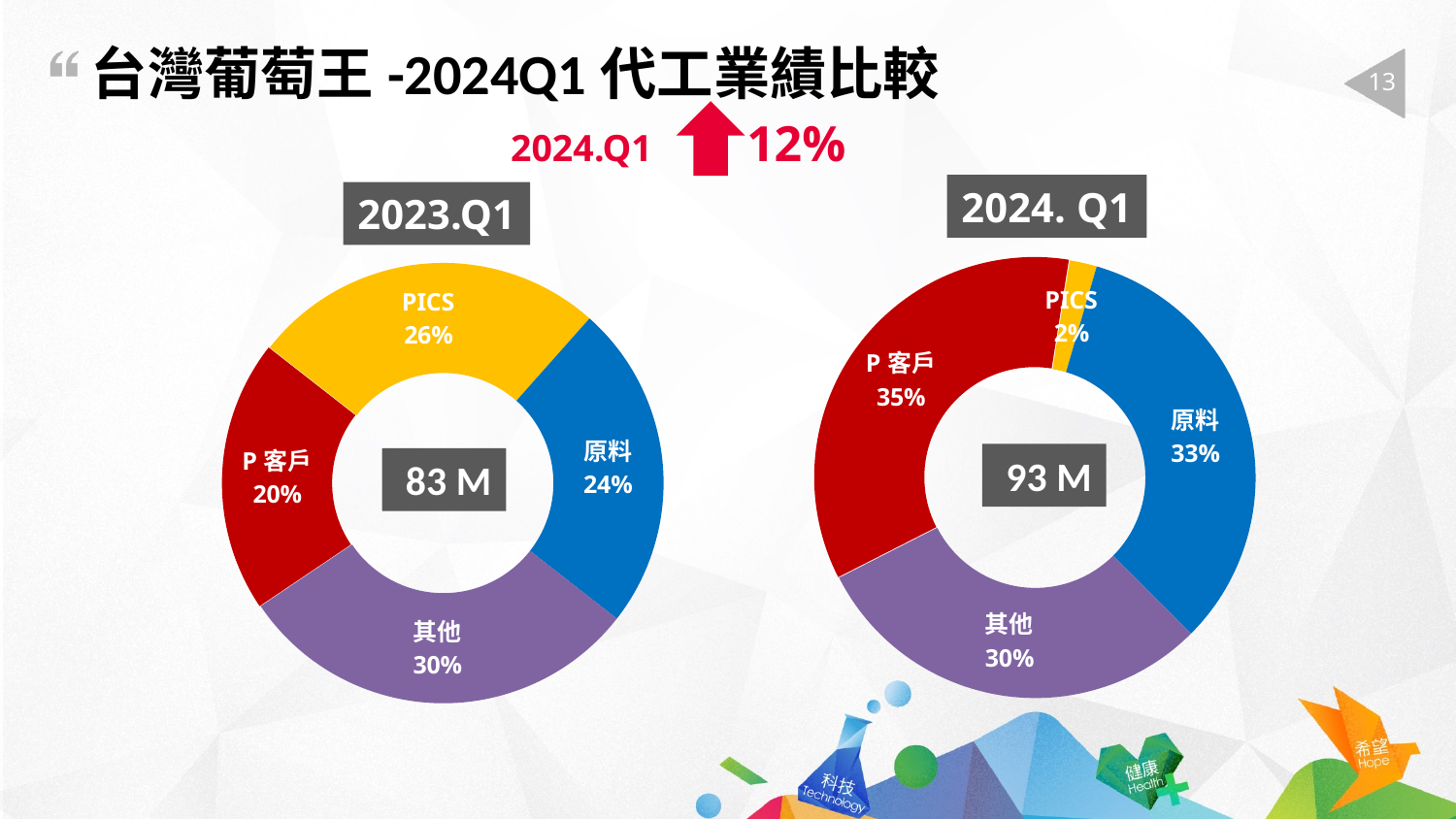
In the 2024. Q1 chart, which is larger: P 客戶 or 原料? P 客戶 What value is shown in the centre of the 2024. Q1 chart? 93 M In the 2023.Q1 chart, which category has the smallest share? P 客戶 What value is shown in the centre of the 2023.Q1 chart? 83 M What is the difference between the PICS share in the 2023.Q1 chart and the PICS share in the 2024. Q1 chart? 24% In the 2024. Q1 chart, which category has the smallest share? PICS What kind of chart is the 2024. Q1 chart? Doughnut chart In the 2024. Q1 chart, what share does 原料 have? 33% In the 2023.Q1 chart, what share does PICS have? 26% How many categories does the 2023.Q1 chart show? 4 In the 2023.Q1 chart, which category has the largest share? 其他 In the 2024. Q1 chart, what share does P 客戶 have? 35%